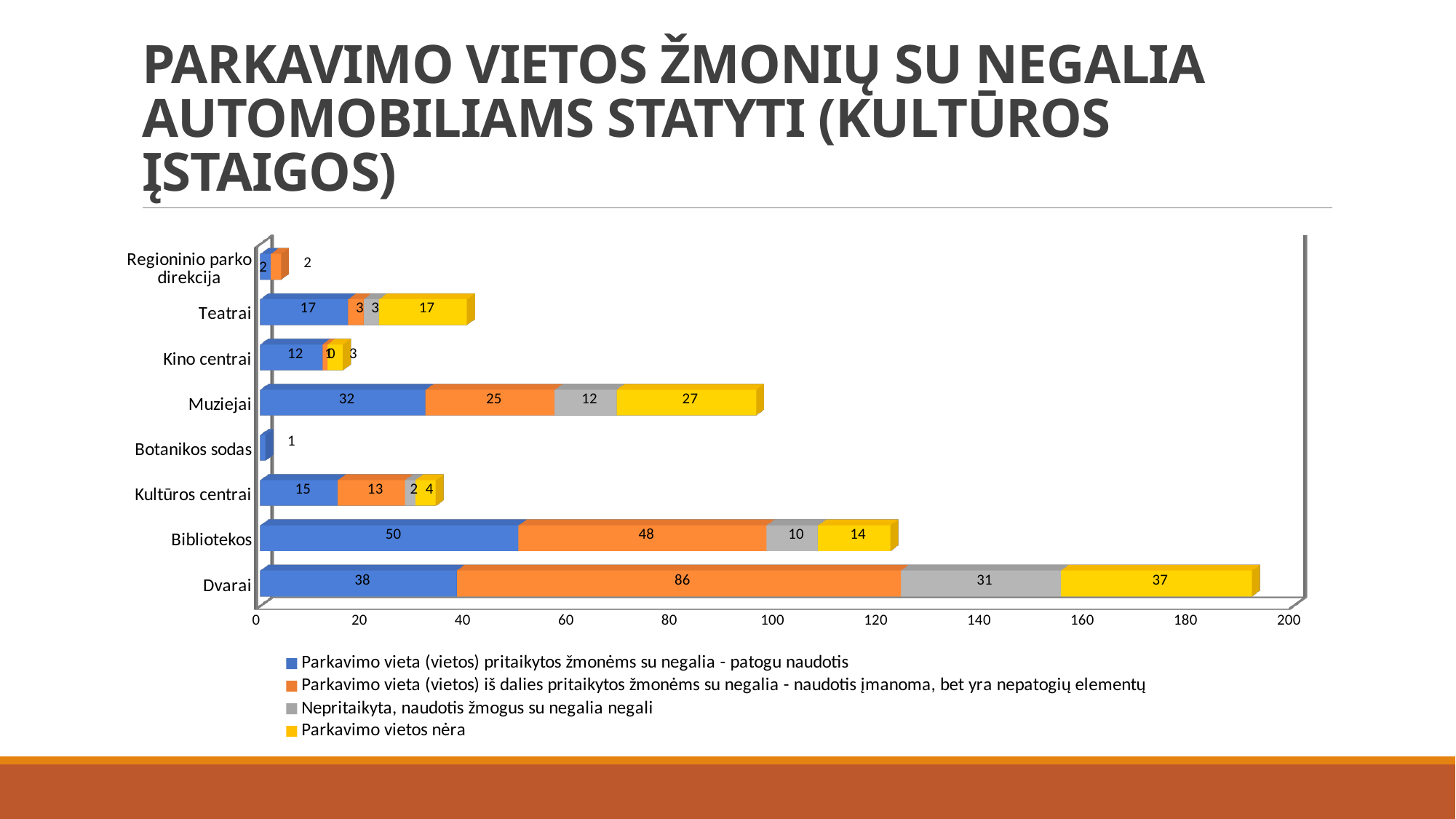
What is the value of 'Parkavimo vieta (vietos) iš dalies pritaikytos žmonėms su negalia - naudotis įmanoma, bet yra nepatogių elementų' for Dvarai? 86 What is the difference between the 'Parkavimo vieta (vietos) pritaikytos žmonėms su negalia - patogu naudotis' values for Bibliotekos and Dvarai? 12 How many categories are shown on the vertical axis of the chart? 8 How many series does the legend list? 4 What is the value of 'Parkavimo vietos nėra' for Muziejai? 27 What is the value of 'Nepritaikyta, naudotis žmogus su negalia negali' for Bibliotekos? 10 What type of chart is shown on the slide? stacked bar chart Which category has the longest total bar? Dvarai Which category has the shortest total bar? Botanikos sodas Is the total bar for Muziejai greater or less than 80? greater Which is larger: the 'Parkavimo vietos nėra' value for Teatrai or for Bibliotekos? Teatrai What is the total of the stacked bar for Bibliotekos? 122